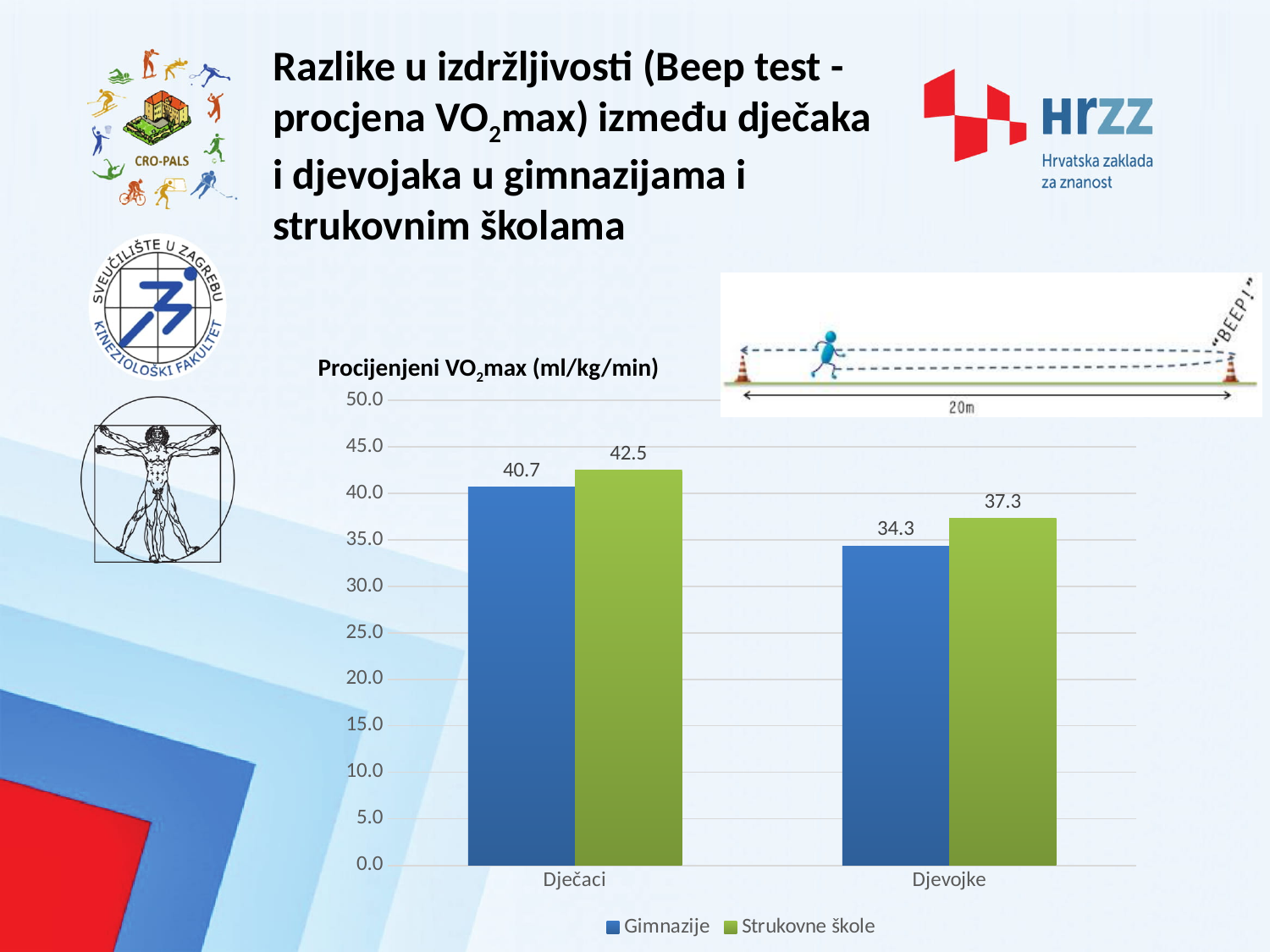
What is the estimated VO2max value for Djevojke in the Strukovne škole series? 37.3 What is the estimated VO2max value for Dječaci in the Gimnazije series? 40.7 What is the estimated VO2max value for Djevojke in the Gimnazije series? 34.3 How many categories are shown on the x axis? 2 Which bar has the lowest value on the chart? Djevojke, Gimnazije How many series does the legend list? 2 Which bar has the highest value on the chart? Dječaci, Strukovne škole What kind of chart is shown on the slide? Bar chart What is the estimated VO2max value for Dječaci in the Strukovne škole series? 42.5 What is the difference between the Strukovne škole and Gimnazije values for Dječaci? 1.8 Which is larger: the Gimnazije value for Dječaci or the Strukovne škole value for Djevojke? Gimnazije value for Dječaci What is the difference between the Strukovne škole and Gimnazije values for Djevojke? 3.0